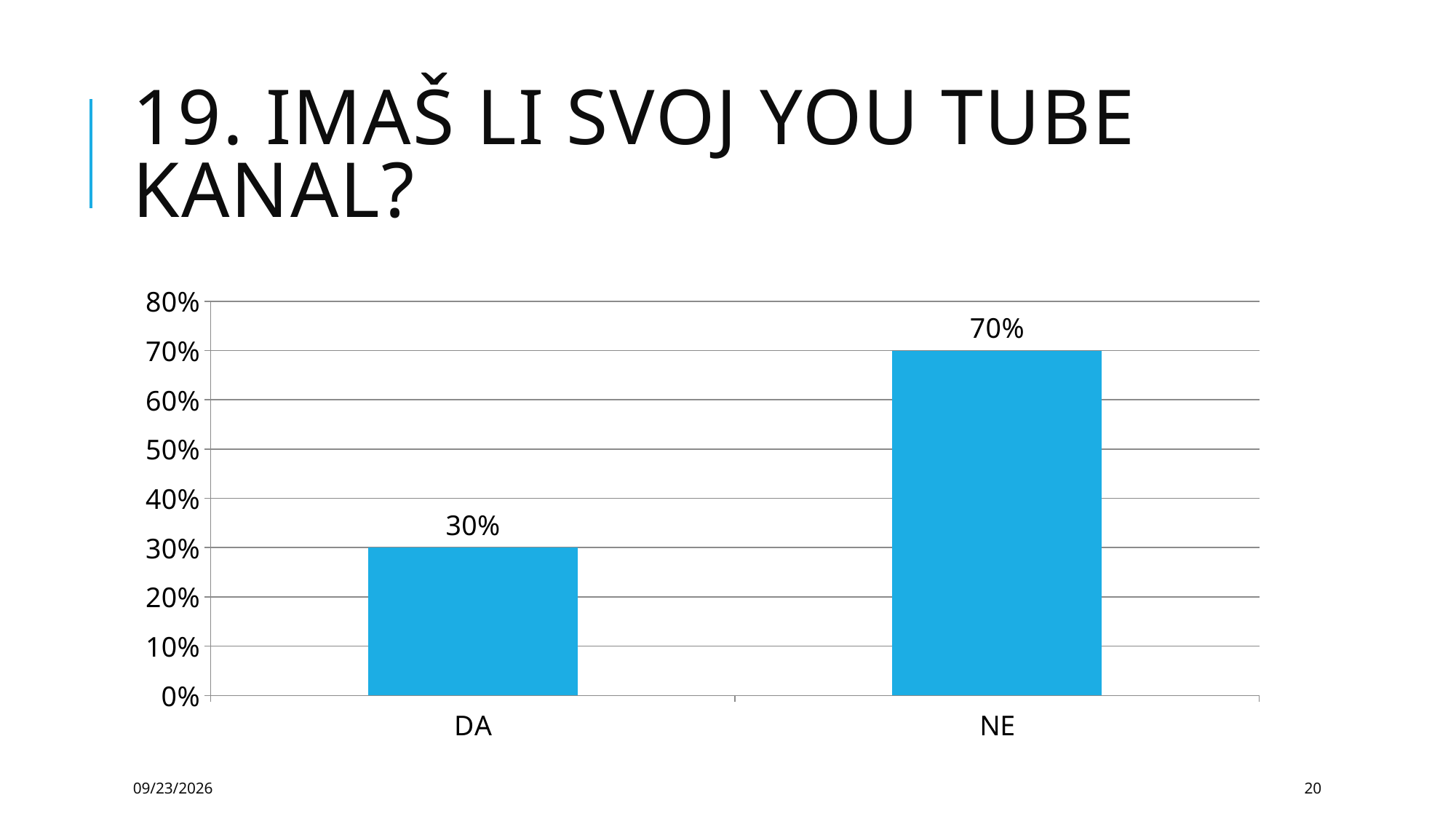
What is the highest value shown on the vertical axis? 80% What is the title of the slide? 19. IMAŠ LI SVOJ YOU TUBE KANAL? Is the value for DA greater or less than 40%? less Which category has the highest value? NE Which category has the lowest value? DA Which is larger, the value for DA or the value for NE? NE Is the value for NE greater or less than 60%? greater What is the difference between the values for NE and DA? 40% What kind of chart is shown on the slide? bar chart What is the value for NE? 70% How many categories are shown on the x axis? 2 What is the value for DA? 30%